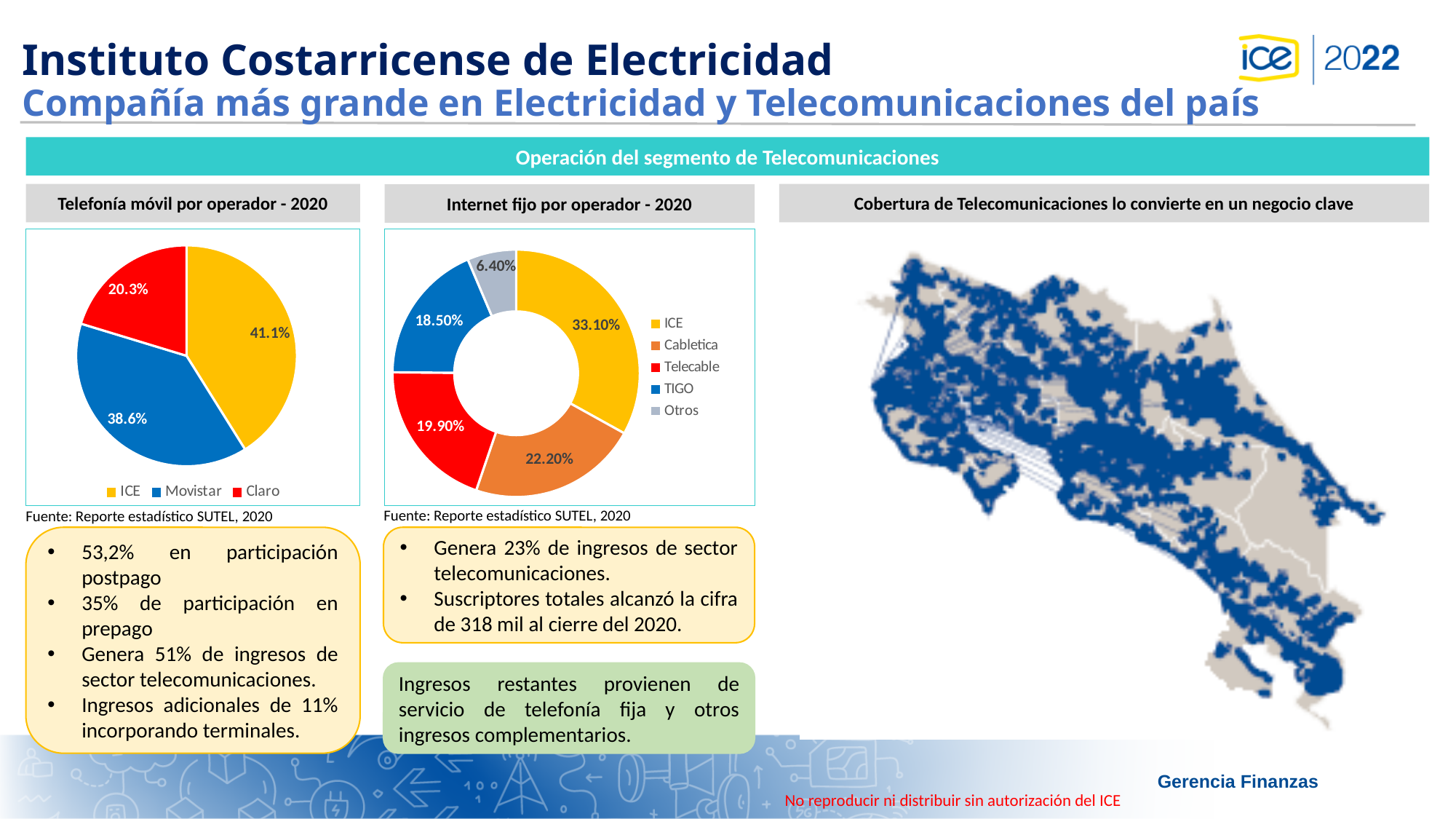
How many entries does the legend of the 'Internet fijo por operador - 2020' chart list? 5 In the 'Telefonía móvil por operador - 2020' chart, what share does ICE have? 41.1% What type of chart is 'Telefonía móvil por operador - 2020'? Pie chart In the 'Internet fijo por operador - 2020' chart, which is larger, Telecable or Otros? Telecable In the 'Internet fijo por operador - 2020' chart, which category has the largest share? ICE In the 'Telefonía móvil por operador - 2020' chart, what is the difference between the ICE and Movistar shares? 2.5% In the 'Telefonía móvil por operador - 2020' chart, how many operators are shown? 3 In the 'Telefonía móvil por operador - 2020' chart, which operator has the smallest share? Claro In the 'Telefonía móvil por operador - 2020' chart, what share does Claro have? 20.3% In the 'Internet fijo por operador - 2020' chart, what is the difference between the ICE and Cabletica shares? 10.90% In the 'Internet fijo por operador - 2020' chart, what share does Cabletica have? 22.20% In the 'Internet fijo por operador - 2020' chart, what share does TIGO have? 18.50%